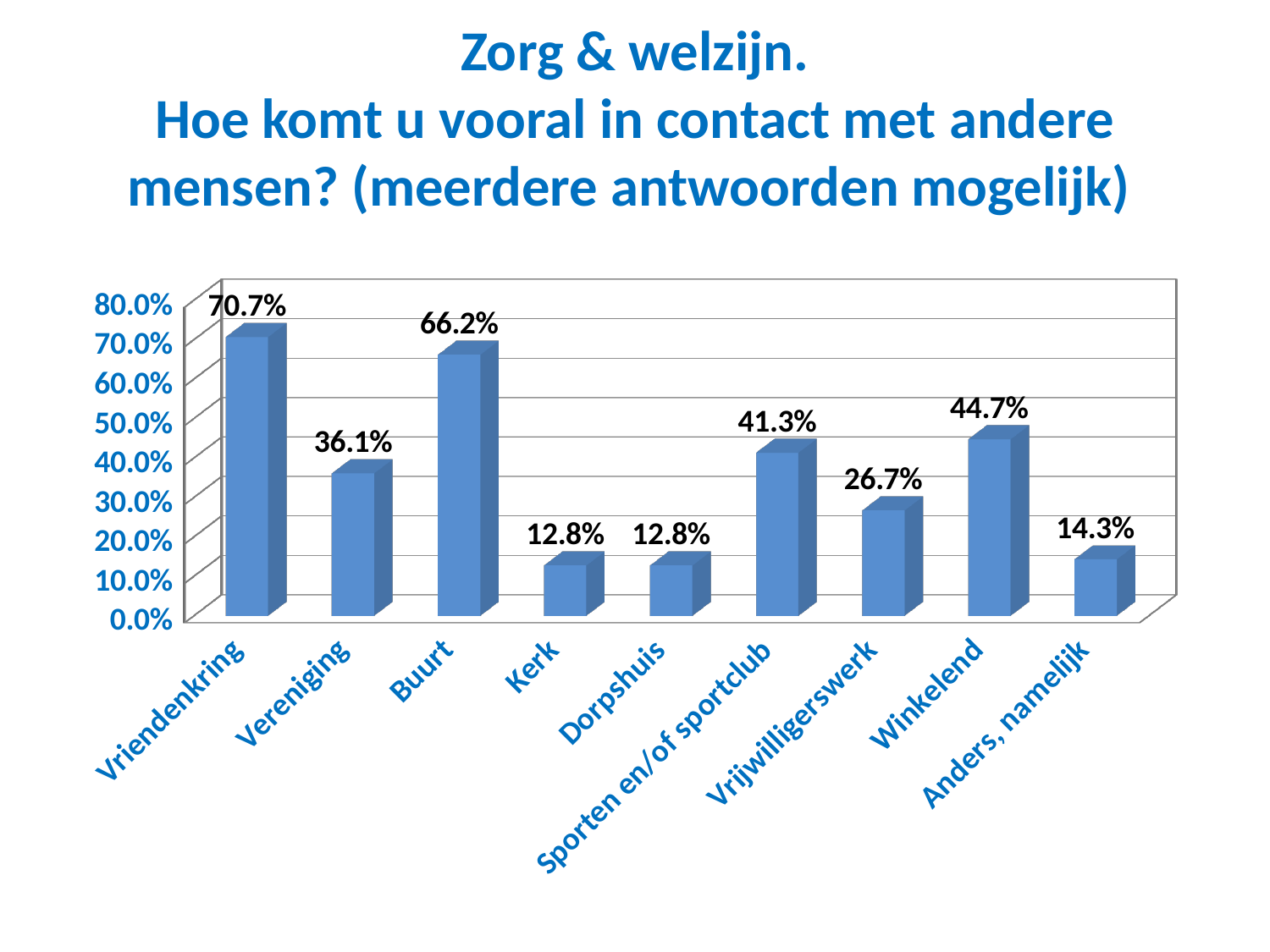
What is the difference between the values for Winkelend and Anders, namelijk? 30.4% What is the value for Vrijwilligerswerk? 26.7% What is the highest value shown on the y axis? 80.0% What is the difference between the values for Buurt and Vereniging? 30.1% Which two categories share the same value of 12.8%? Kerk and Dorpshuis What kind of chart is shown on the slide? bar chart Which category has the highest value? Vriendenkring How many categories are shown on the x axis? 9 Which is larger, the value for Winkelend or the value for Sporten en/of sportclub? Winkelend Is the value for Anders, namelijk greater or less than 20.0%? less What is the value for Sporten en/of sportclub? 41.3% What is the value for Vriendenkring? 70.7%